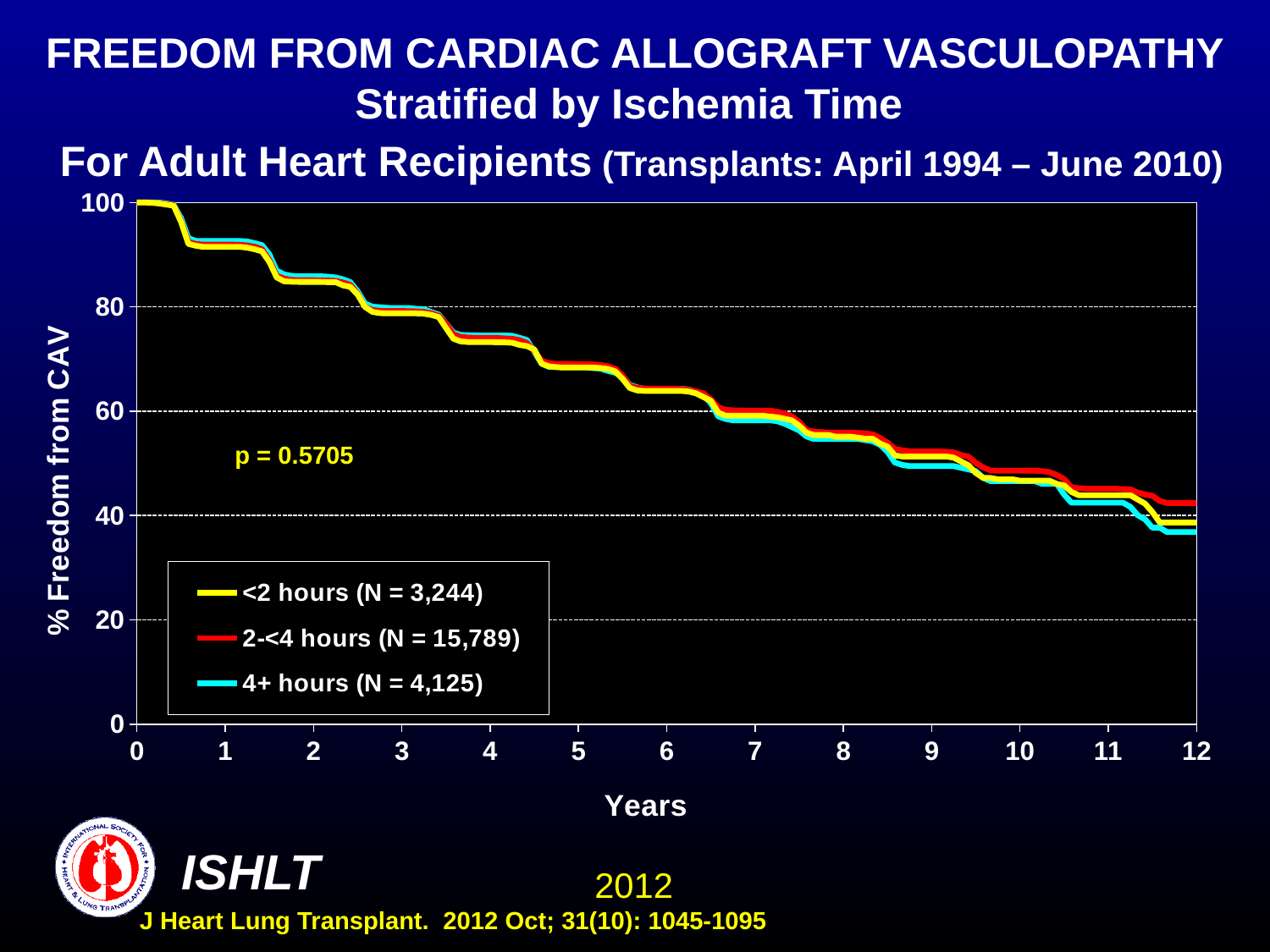
What kind of chart is shown on the slide? Line chart Which group has the highest % freedom from CAV at year 12? 2-<4 hours What is the p-value shown on the chart? p = 0.5705 Is the value for the <2 hours group at year 6 greater or less than 60? greater Which group has the lowest % freedom from CAV at year 12? 4+ hours How many series does the legend list? 3 Is the value for the 4+ hours group at year 9 greater or less than 40? greater What is the maximum value shown on the y axis? 100 Do the curves rise or fall as years increase along the x axis? Fall Is the value for the 2-<4 hours group at year 9 greater or less than 60? less What is the N for the 2-<4 hours group in the legend? 15,789